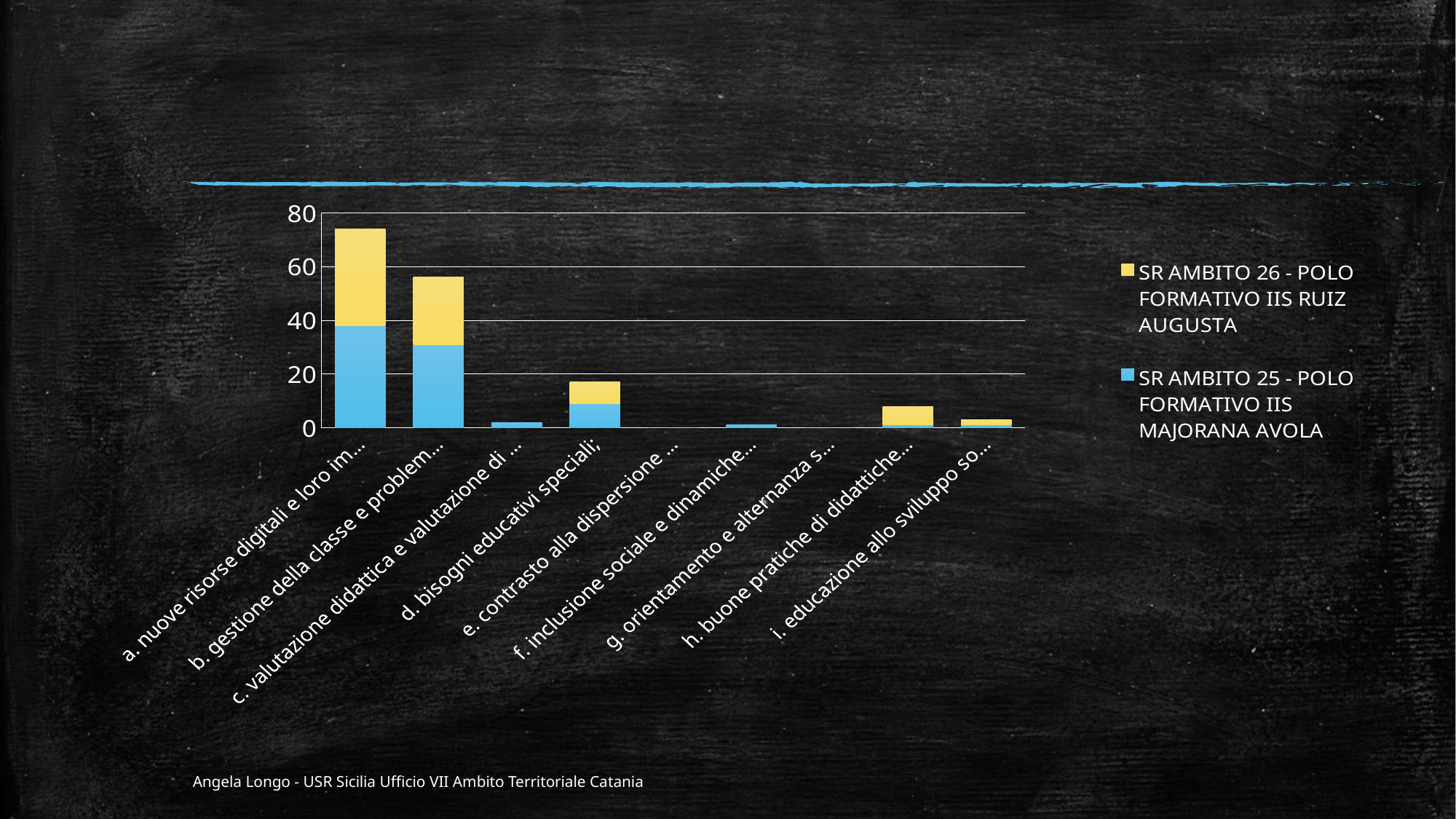
Is the value of SR AMBITO 25 - POLO FORMATIVO IIS MAJORANA AVOLA for "b. gestione della classe e problem..." greater or less than 20? greater How many categories are shown on the x axis of the chart? 9 What kind of chart is shown on the slide? stacked bar chart What colour represents SR AMBITO 26 - POLO FORMATIVO IIS RUIZ AUGUSTA in the chart? yellow What is the highest value shown on the chart's vertical axis? 80 Is the total stacked value for "a. nuove risorse digitali e loro im..." greater or less than 60? greater Which category has the tallest stacked bar in the chart? a. nuove risorse digitali e loro im... Which has the larger total stacked bar: "d. bisogni educativi speciali;" or "h. buone pratiche di didattiche..."? d. bisogni educativi speciali; How many series does the chart's legend list? 2 Is the total stacked value for "d. bisogni educativi speciali;" greater or less than 20? less Which has the larger total stacked bar: "a. nuove risorse digitali e loro im..." or "b. gestione della classe e problem..."? a. nuove risorse digitali e loro im...